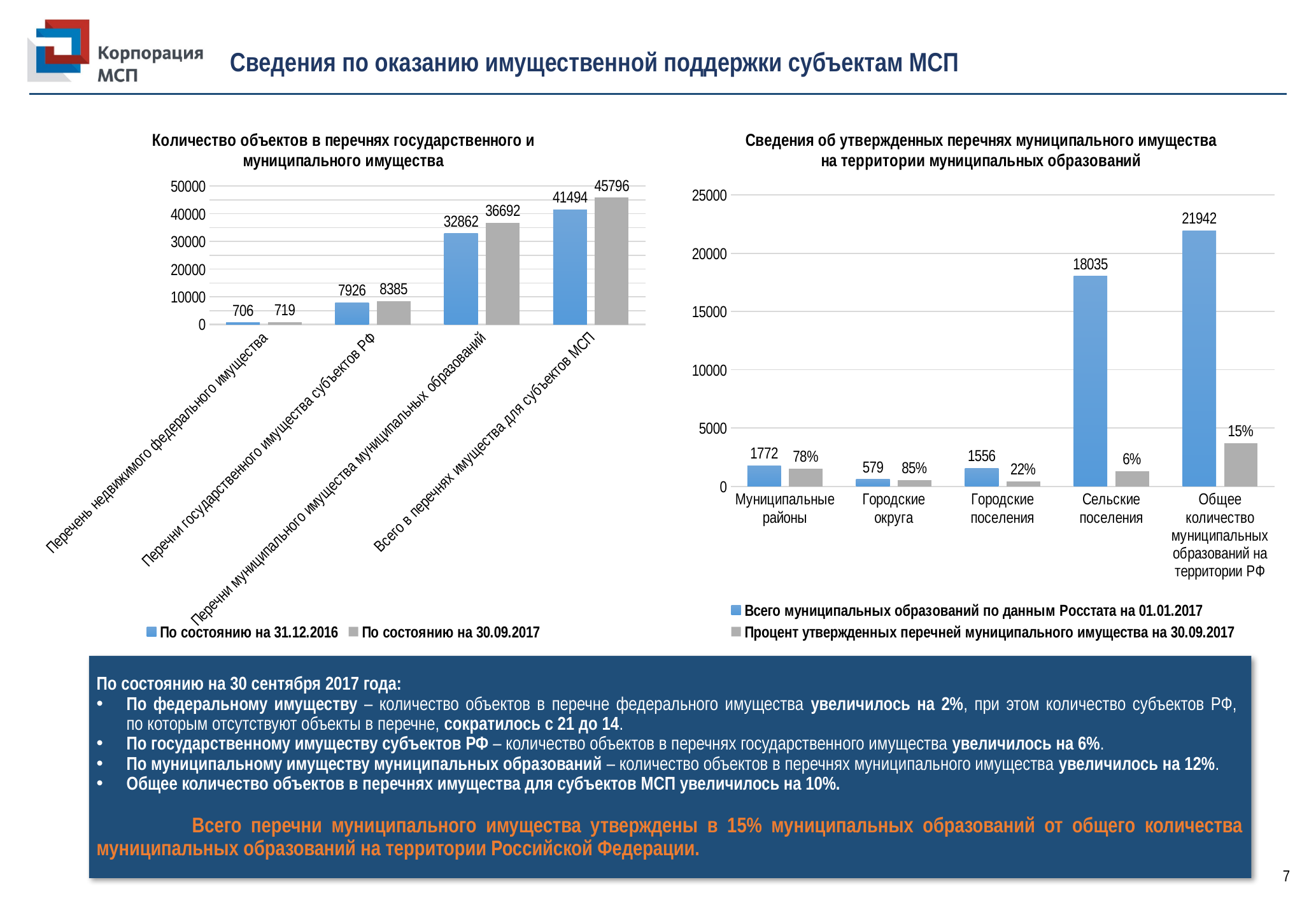
In the right chart 'Сведения об утвержденных перечнях муниципального имущества', which is larger: the number of 'Муниципальные районы' or the number of 'Городские поселения'? Муниципальные районы In the left chart 'Количество объектов в перечнях государственного и муниципального имущества', which category has the lowest values? Перечень недвижимого федерального имущества What type of chart is the right chart 'Сведения об утвержденных перечнях муниципального имущества'? Bar chart In the left chart 'Количество объектов в перечнях государственного и муниципального имущества', what is the value for 'Перечни государственного имущества субъектов РФ' as of 30.09.2017? 8385 In the left chart 'Количество объектов в перечнях государственного и муниципального имущества', by how much did 'Всего в перечнях имущества для субъектов МСП' increase from 31.12.2016 to 30.09.2017? 4302 In the right chart 'Сведения об утвержденных перечнях муниципального имущества', what is the number of 'Сельские поселения' according to Rosstat as of 01.01.2017? 18035 In the right chart 'Сведения об утвержденных перечнях муниципального имущества', what percentage of approved lists is shown for 'Городские округа'? 85% In the left chart 'Количество объектов в перечнях государственного и муниципального имущества', how many categories are shown on the x axis? 4 In the left chart 'Количество объектов в перечнях государственного и муниципального имущества', what is the value for 'Перечень недвижимого федерального имущества' as of 31.12.2016? 706 In the left chart 'Количество объектов в перечнях государственного и муниципального имущества', how many series does the legend list? 2 In the right chart 'Сведения об утвержденных перечнях муниципального имущества', which category has the lowest percentage of approved lists? Сельские поселения In the right chart 'Сведения об утвержденных перечнях муниципального имущества', what is the difference between the number of 'Муниципальные районы' and 'Городские округа'? 1193